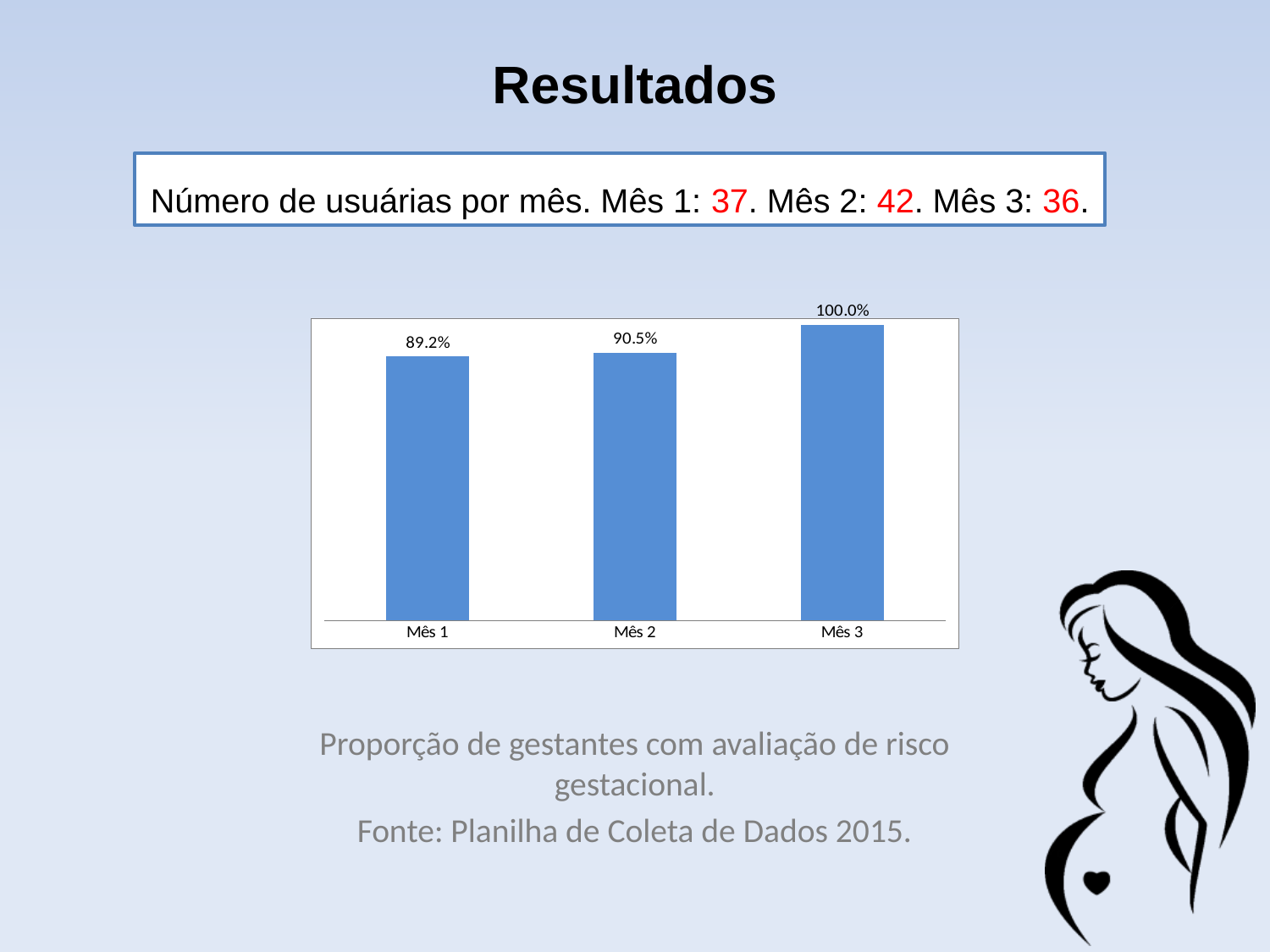
What is the value for Mês 3? 100.0% What does the caption below the chart say the chart shows? Proporção de gestantes com avaliação de risco gestacional. How many months are shown on the chart? 3 What is the difference between the values for Mês 3 and Mês 1? 10.8% Which is larger, the value for Mês 3 or the value for Mês 2? Mês 3 Which month has the lowest value? Mês 1 Which month has the highest value? Mês 3 What kind of chart is shown on the slide? Bar chart What is the value for Mês 2? 90.5% Do the values rise or fall from Mês 1 to Mês 3? Rise What is the value for Mês 1? 89.2% What is the difference between the values for Mês 2 and Mês 1? 1.3%